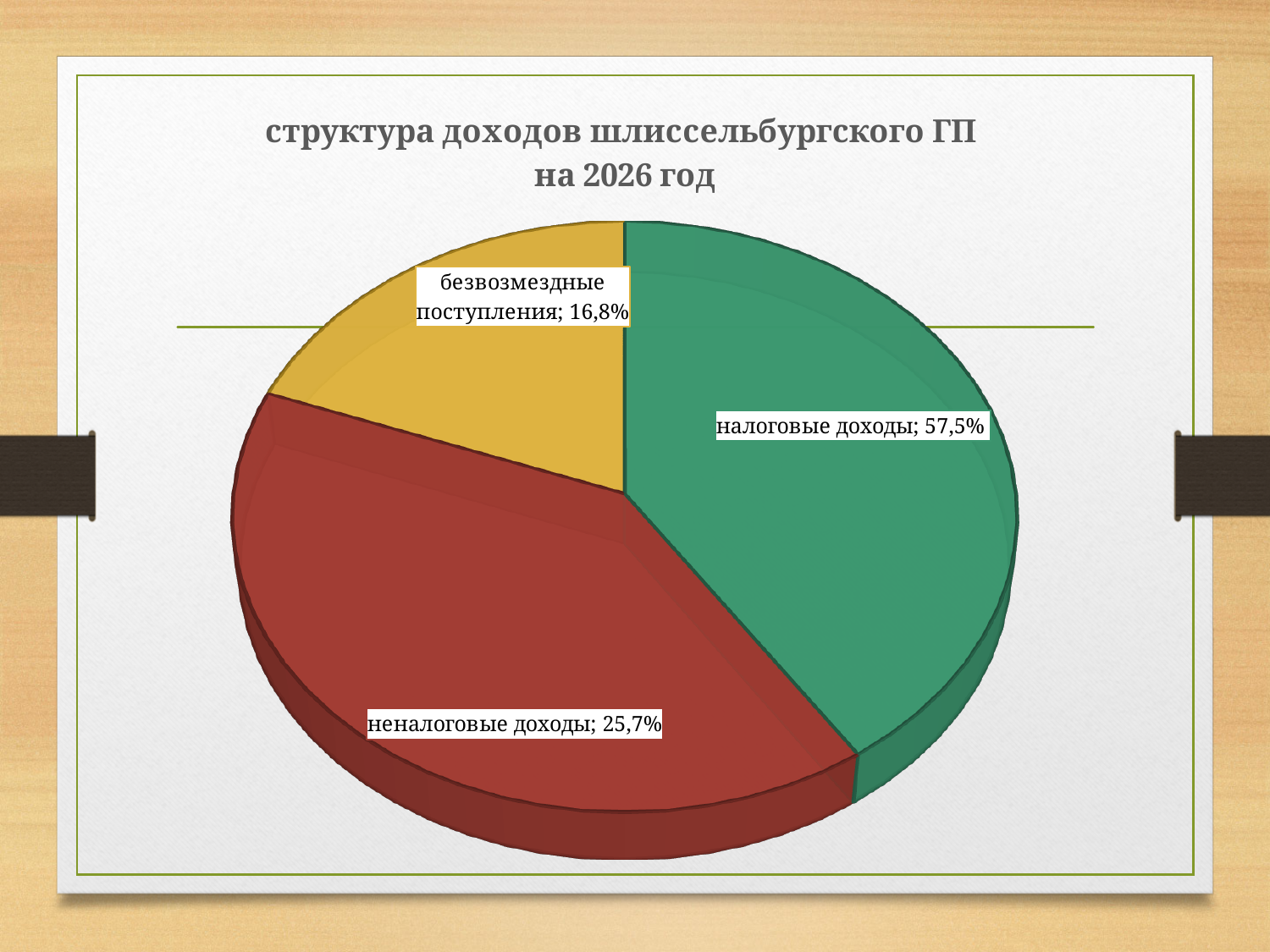
What colour is the slice for налоговые доходы? green Which category has the smallest slice of the pie? безвозмездные поступления What share of the pie is labelled for неналоговые доходы? 25,7% What is the difference in percentage points between неналоговые доходы and безвозмездные поступления? 8,9 What share of the pie is labelled for налоговые доходы? 57,5% Which is larger, the slice for неналоговые доходы or the slice for безвозмездные поступления? неналоговые доходы What kind of chart is shown on the slide? pie chart What share of the pie is labelled for безвозмездные поступления? 16,8% Which category has the largest slice of the pie? налоговые доходы How many slices does the pie chart have? 3 What is the title of the chart? структура доходов шлиссельбургского ГП на 2026 год What is the difference in percentage points between налоговые доходы and неналоговые доходы? 31,8